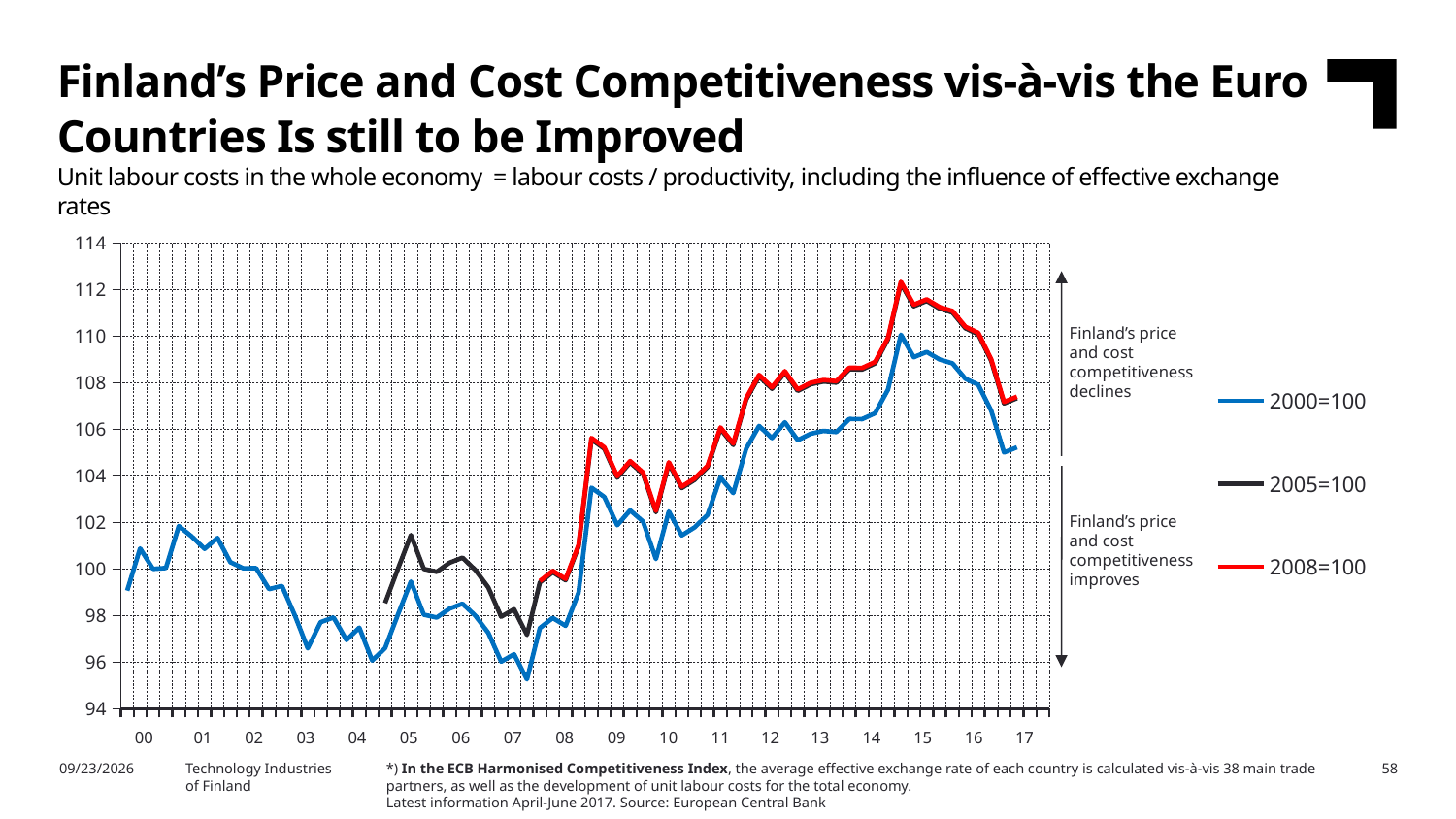
What kind of chart is shown on the slide? line chart Which series is drawn in blue? 2000=100 Which series is drawn in red? 2008=100 Does the 2008=100 series rise or fall between 2015 and 2017? fall Is the value of the 2000=100 series at its 2015 peak greater or less than 108? greater Is the lowest value of the 2000=100 series around 2007 greater or less than 96? less Is the value of the 2000=100 series at the end of the chart in 2017 greater or less than 106? less Does the 2000=100 series rise or fall between 2008 and 2015? rise How many years are labelled on the x axis? 18 Which series has the higher value in 2015, 2000=100 or 2008=100? 2008=100 How many series does the legend list? 3